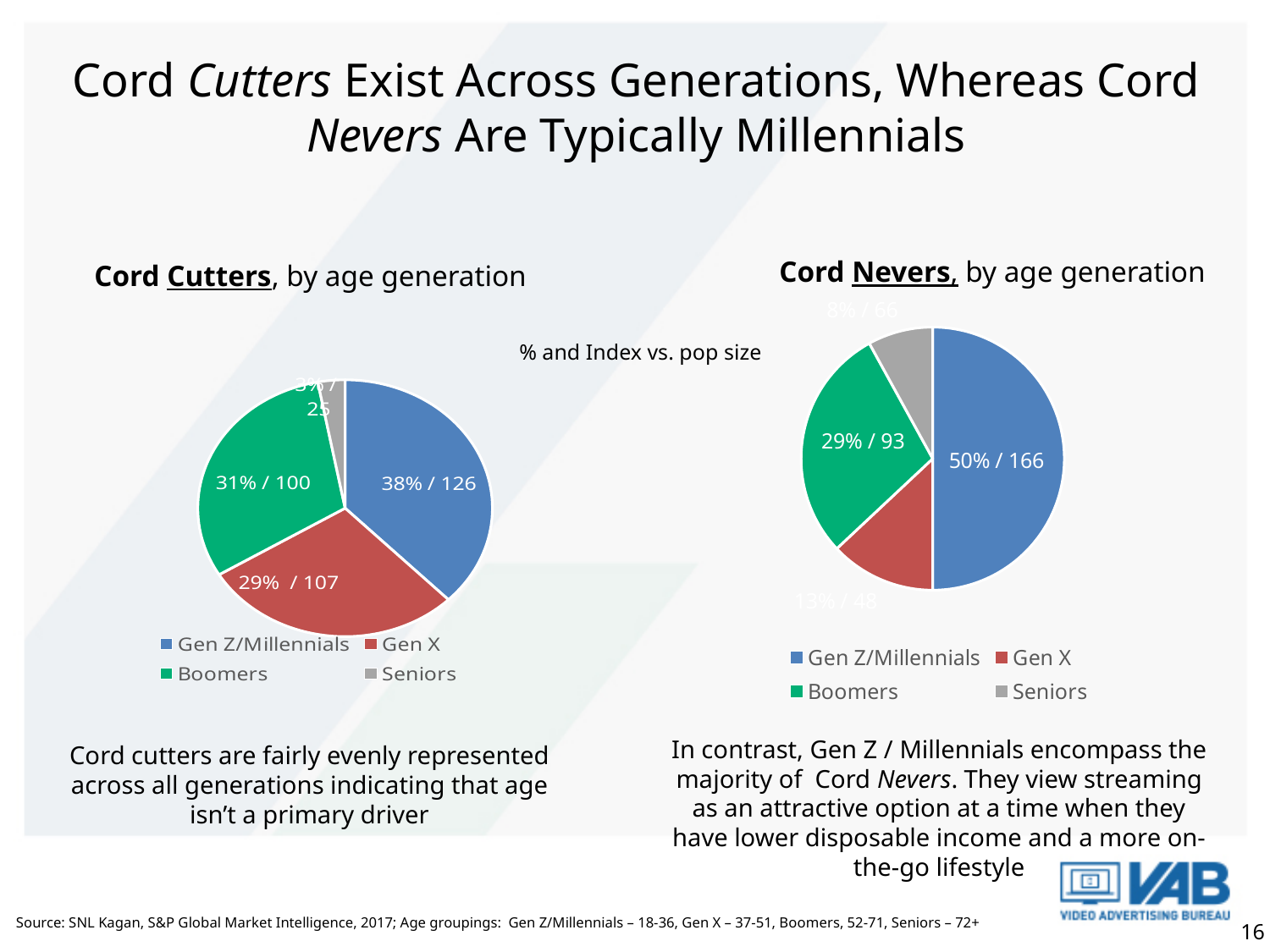
In the Cord Cutters pie chart, what label is shown on the Gen Z/Millennials slice? 38% / 126 In the Cord Nevers pie chart, what label is shown on the Gen Z/Millennials slice? 50% / 166 In the Cord Cutters pie chart, which generation has the largest share? Gen Z/Millennials In the Cord Cutters pie chart, what percentage of cord cutters are Boomers? 31% How many generation categories does the legend of the Cord Nevers chart list? 4 In the Cord Nevers pie chart, which is larger: the Gen Z/Millennials share or the Boomers share? Gen Z/Millennials In the Cord Nevers pie chart, what percentage of cord nevers are Boomers? 29% What type of chart is used for Cord Cutters by age generation? Pie chart In the Cord Nevers pie chart, which generation has the smallest share? Seniors In the Cord Cutters pie chart, what colour represents Boomers? Green In the Cord Cutters pie chart, how many percentage points larger is the Gen Z/Millennials share than the Boomers share? 7 percentage points In the Cord Cutters pie chart, what is the index value shown for Gen X? 107